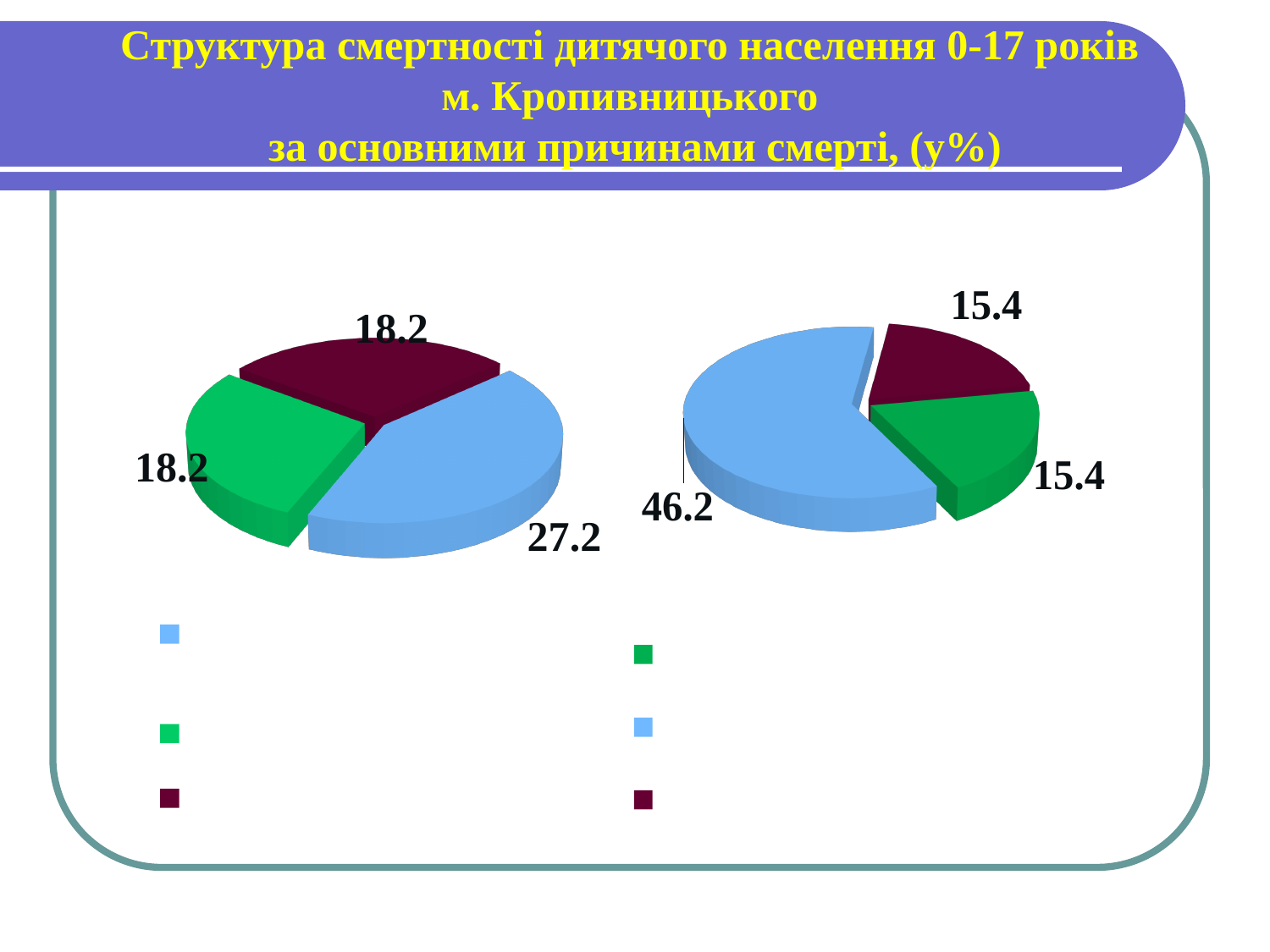
How many slices does the right pie chart have? 3 What kind of chart is shown on the right of the slide? pie chart In the right pie chart, which colour slice has the largest value? light blue Which is larger: the light blue slice in the left pie chart or the light blue slice in the right pie chart? the right pie chart In the right pie chart, what is the difference between the light blue slice and the green slice? 30.8 What kind of chart is shown on the left of the slide? pie chart In the left pie chart, what is the difference between the light blue slice and the dark red slice? 9.0 In the right pie chart, what value is labelled on the light blue slice? 46.2 In the left pie chart, what value is labelled on the green slice? 18.2 In the left pie chart, which colour slice has the largest value? light blue In the left pie chart, what value is labelled on the light blue slice? 27.2 In the right pie chart, what value is labelled on the dark red slice? 15.4